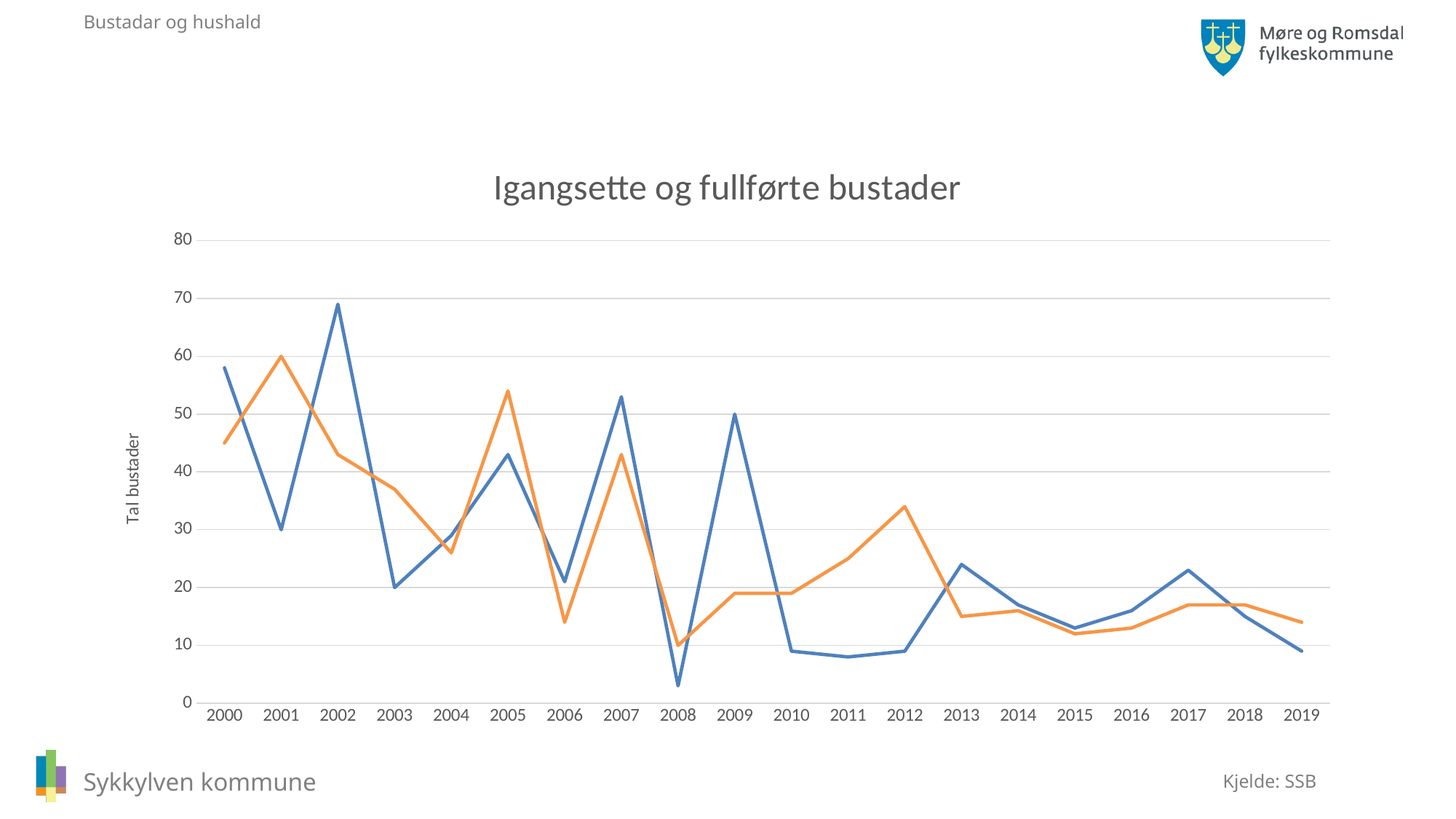
How many years are shown along the x axis of the chart? 20 What is the value of the blue line in 2009? 50 What type of chart is shown on the slide? line chart Is the value of the blue line in 2002 greater or less than 60? greater Overall, do the values of the blue line rise or fall from 2000 to 2019? fall In 2012, which line has the larger value, the blue line or the orange line? the orange line What is the value of the orange line in 2001? 60 What is the label on the vertical axis of the chart? Tal bustader What is the value of the blue line in 2001? 30 In which year does the blue line reach its highest value? 2002 In which year does the blue line reach its lowest value? 2008 What is the title of the chart? Igangsette og fullførte bustader